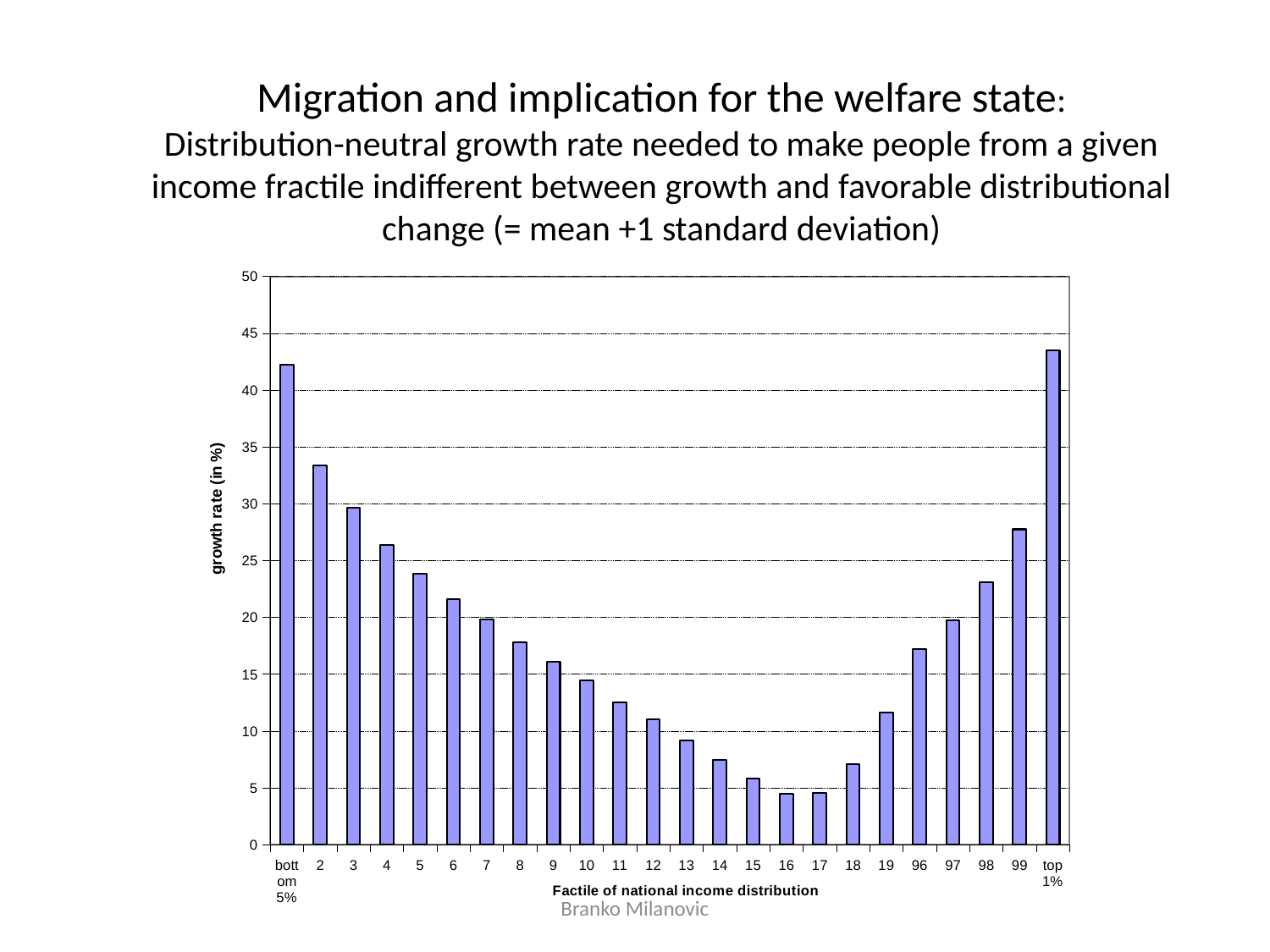
What is the label of the vertical axis? growth rate (in %) What kind of chart is shown on the slide? bar chart Which has a higher growth rate, the bottom 5% or fractile 2? bottom 5% Is the growth rate for fractile 98 greater or less than 20? greater Do the growth rates rise or fall from the bottom 5% through fractile 16? fall How many fractile categories are plotted along the x axis? 24 Which fractile has the highest growth rate? top 1% Is the growth rate for fractile 13 greater or less than 10? less Is the growth rate for fractile 2 greater or less than 30? greater